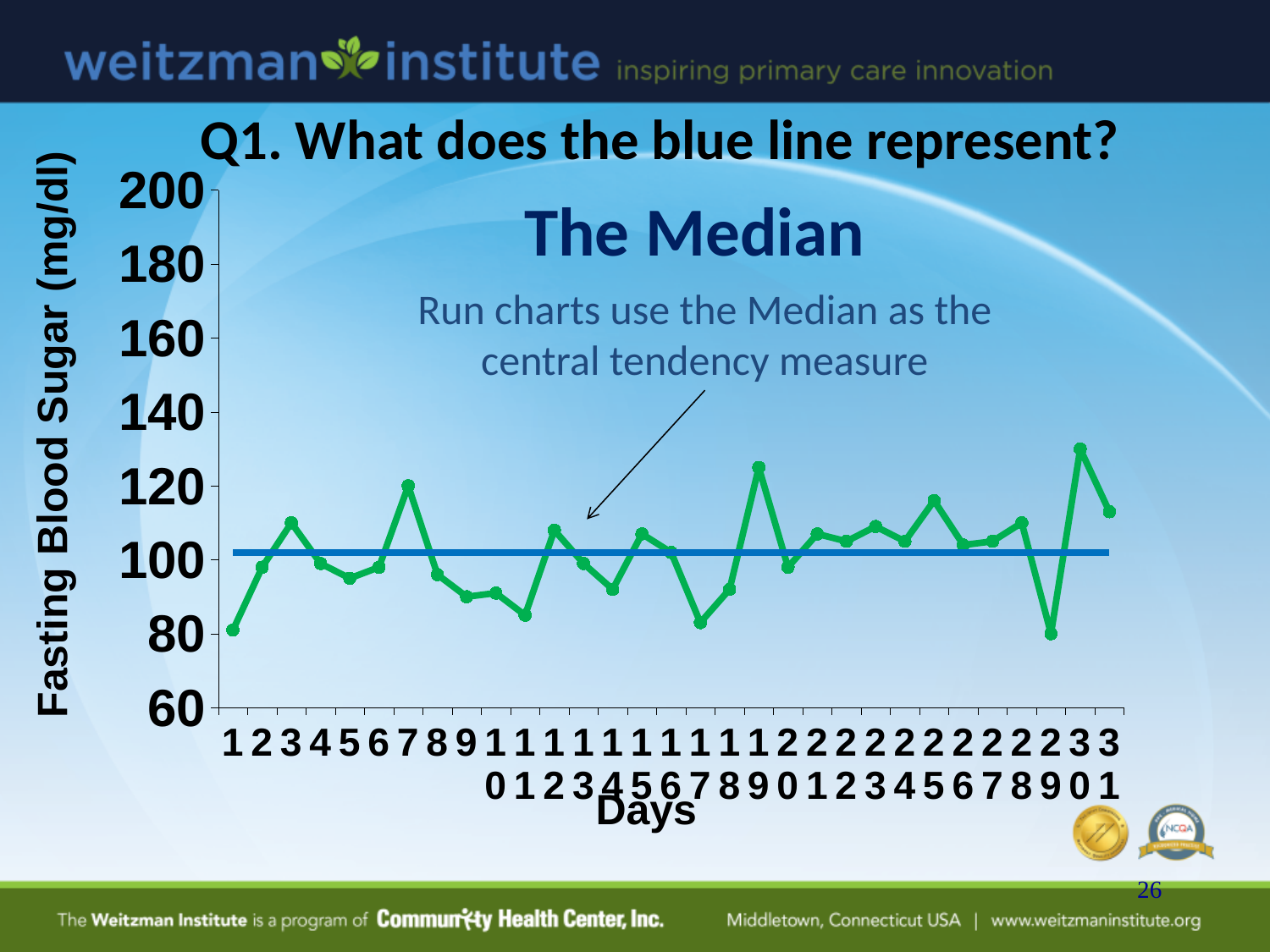
What kind of chart is shown on the slide? line chart Which is larger, the value for day 29 or the value for day 30? day 30 How many days (data points) are plotted on the x axis? 31 Is the value for day 30 greater or less than 120? greater What is the label of the y axis? Fasting Blood Sugar (mg/dl) Is the value for day 29 greater or less than 100? less On which day is the fasting blood sugar value highest? 30 Is the value for day 17 greater or less than 100? less Which is larger, the value for day 19 or the value for day 20? day 19 What does the blue horizontal line on the chart represent? The Median